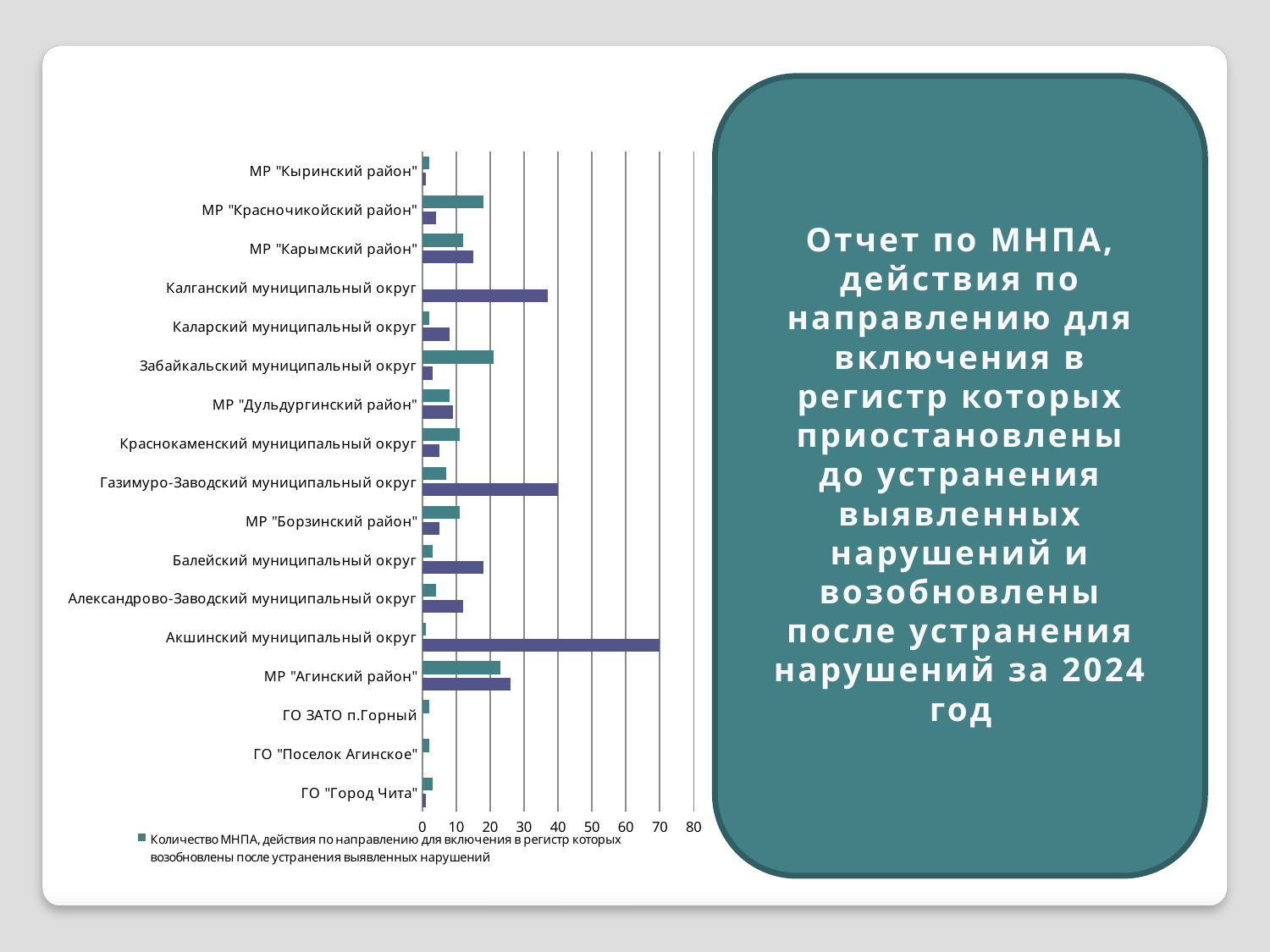
What is the highest value shown on the chart's horizontal axis? 80 What kind of chart is shown on the slide? bar chart Is the teal bar for МР "Красночикойский район" greater or less than 20? less Is the purple bar for МР "Агинский район" greater or less than 20? greater How many categories (municipalities) are listed on the chart's vertical axis? 17 Which has the longer purple bar: Акшинский муниципальный округ or Калганский муниципальный округ? Акшинский муниципальный округ What year does the report title on the slide refer to? 2024 Which category has the longest bar on the chart? Акшинский муниципальный округ Is the longer (purple) bar for Калганский муниципальный округ greater or less than 40? less Which has the longer teal bar: МР "Агинский район" or МР "Кыринский район"? МР "Агинский район"